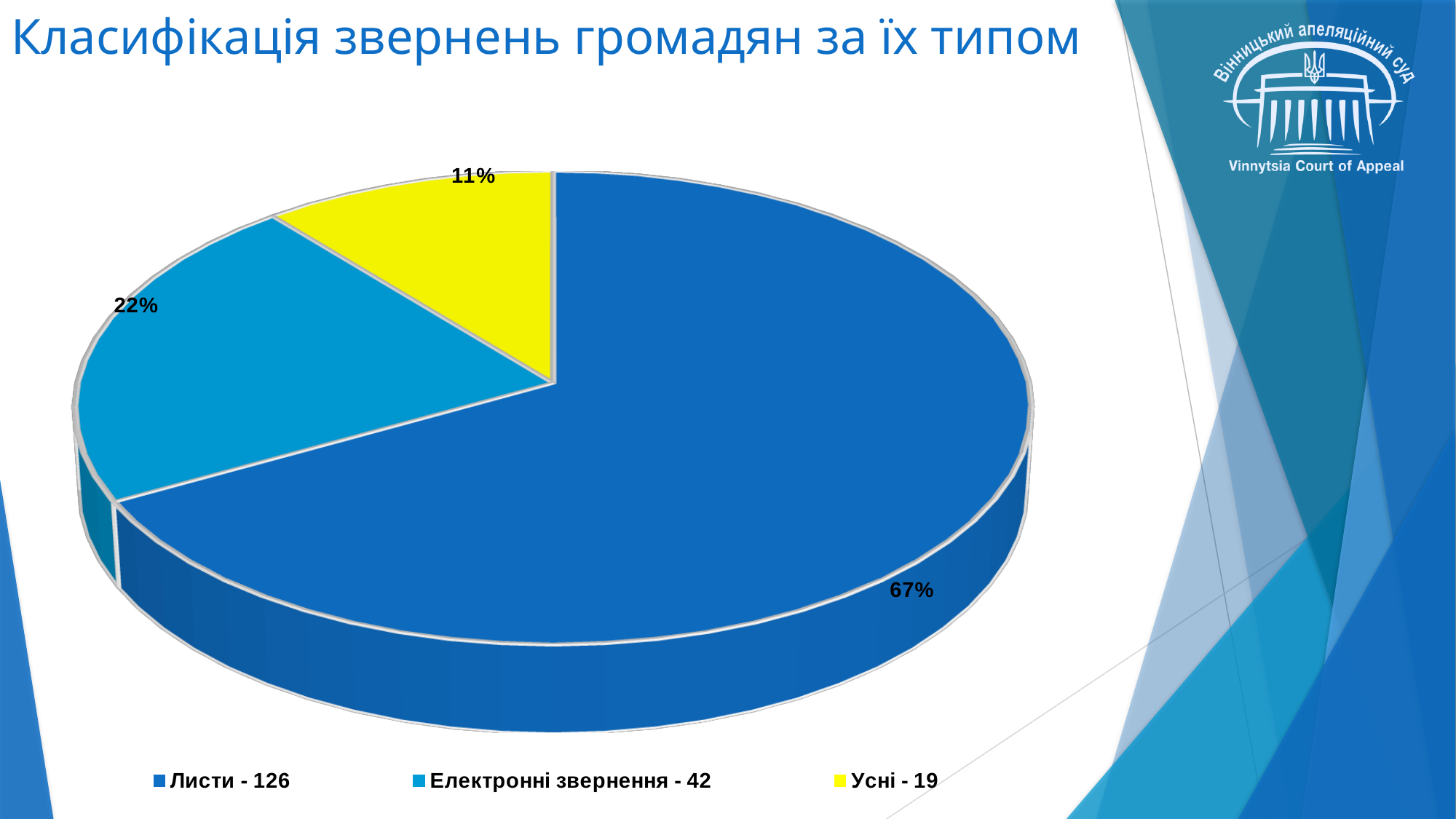
What is the difference in percentage points between the "Листи - 126" slice and the "Електронні звернення - 42" slice? 45% What is the title of the chart on the slide? Класифікація звернень громадян за їх типом What kind of chart is shown on the slide? pie chart What share of the pie does the "Усні - 19" slice represent? 11% How many slices does the pie chart have? 3 What colour is the "Усні - 19" slice in the pie chart? yellow Which category has the largest slice of the pie? Листи - 126 What share of the pie does the "Електронні звернення - 42" slice represent? 22% What share of the pie does the "Листи - 126" slice represent? 67% How many entries does the legend list? 3 Which slice is larger: "Електронні звернення - 42" or "Усні - 19"? Електронні звернення - 42 Which category has the smallest slice of the pie? Усні - 19